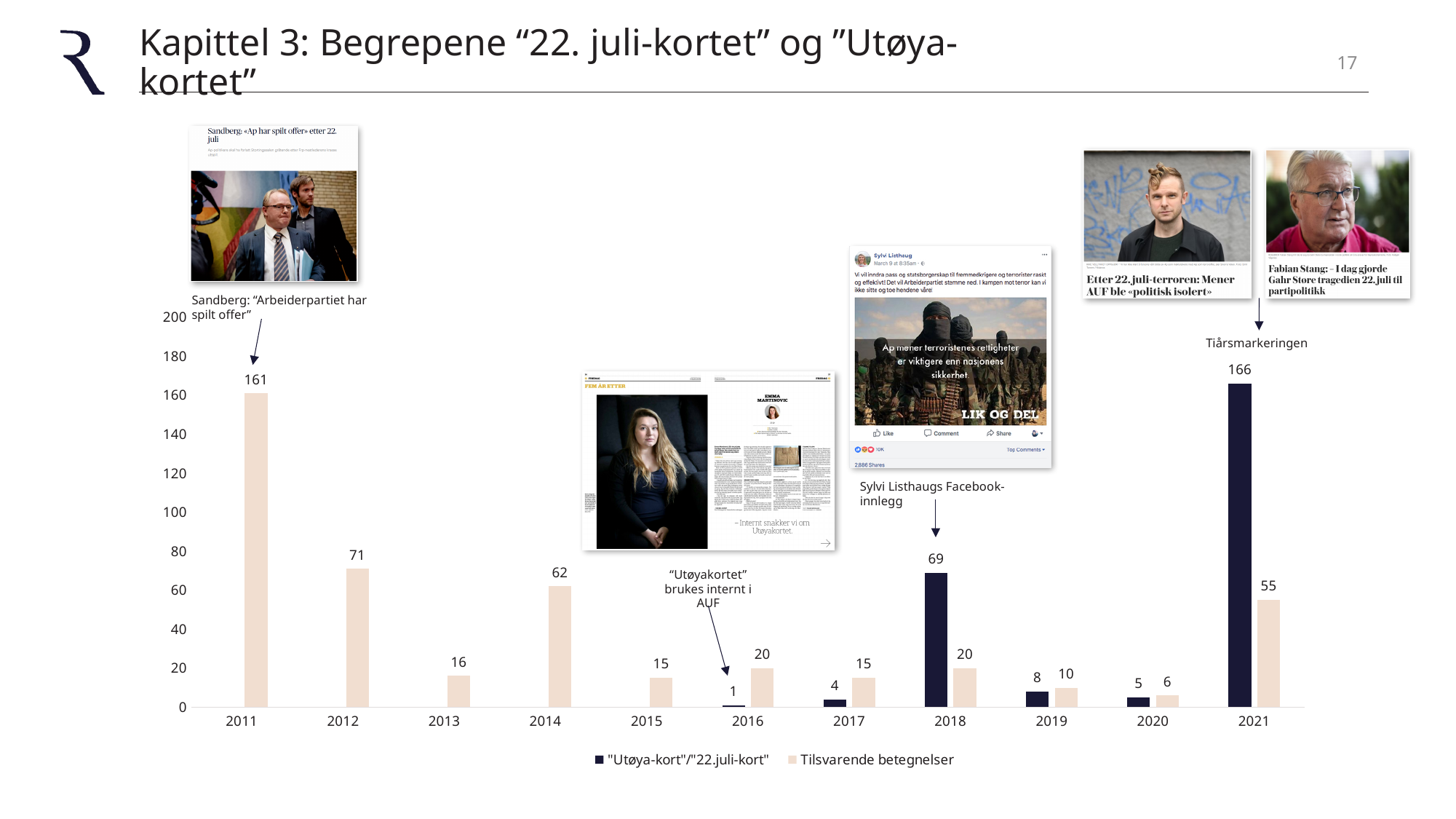
How many series does the chart legend list? 2 How many years are shown on the x axis of the chart? 11 What is the value for "Utøya-kort"/"22.juli-kort" in 2018? 69 What is the value for "Tilsvarende betegnelser" in 2011? 161 What type of chart is shown on the slide? bar chart Is the "Tilsvarende betegnelser" value for 2012 greater or less than 60? greater What is the difference between the "Utøya-kort"/"22.juli-kort" value and the "Tilsvarende betegnelser" value in 2021? 111 Which is larger in 2019: the "Utøya-kort"/"22.juli-kort" value or the "Tilsvarende betegnelser" value? Tilsvarende betegnelser In which year is the "Utøya-kort"/"22.juli-kort" value lowest? 2016 What is the value for "Utøya-kort"/"22.juli-kort" in 2021? 166 Which series in the legend is shown in dark navy? "Utøya-kort"/"22.juli-kort" In which year is the "Tilsvarende betegnelser" value highest? 2011